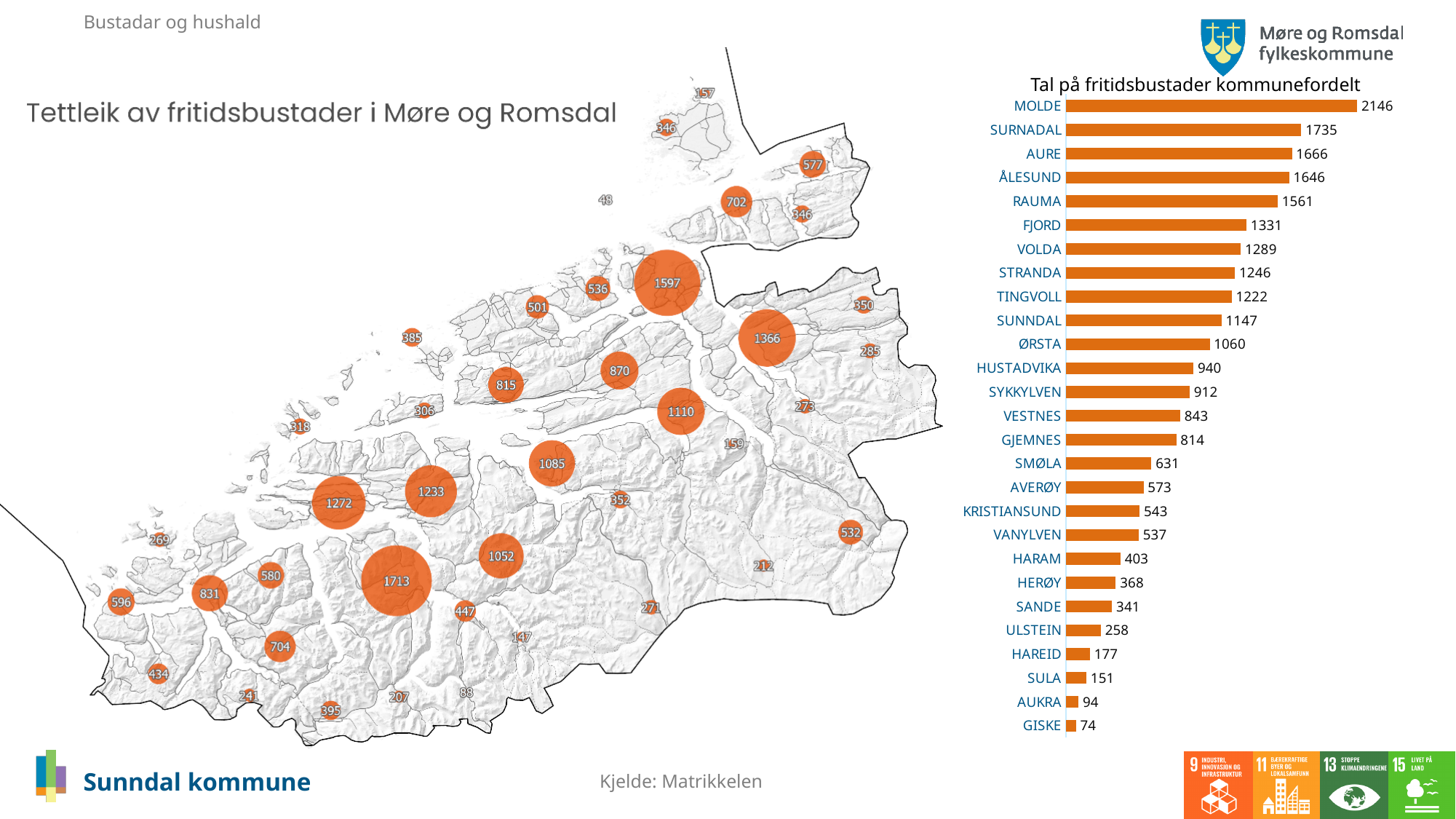
In the bar chart 'Tal på fritidsbustader kommunefordelt', which municipality has the lowest value? GISKE In the bar chart 'Tal på fritidsbustader kommunefordelt', what is the value for GISKE? 74 What kind of chart is 'Tal på fritidsbustader kommunefordelt'? Bar chart In the bar chart 'Tal på fritidsbustader kommunefordelt', what is the difference between the values for MOLDE and SURNADAL? 411 In the bar chart 'Tal på fritidsbustader kommunefordelt', what is the value for HUSTADVIKA? 940 How many municipalities are listed in the bar chart 'Tal på fritidsbustader kommunefordelt'? 27 What is the title of the bar chart on the right side of the slide? Tal på fritidsbustader kommunefordelt In the bar chart 'Tal på fritidsbustader kommunefordelt', what is the value for SUNNDAL? 1147 In the bar chart 'Tal på fritidsbustader kommunefordelt', what is the difference between the values for TINGVOLL and SUNNDAL? 75 In the bar chart 'Tal på fritidsbustader kommunefordelt', which has a larger value, SMØLA or KRISTIANSUND? SMØLA In the bar chart 'Tal på fritidsbustader kommunefordelt', which has a larger value, AURE or ÅLESUND? AURE In the bar chart 'Tal på fritidsbustader kommunefordelt', which municipality has the highest value? MOLDE